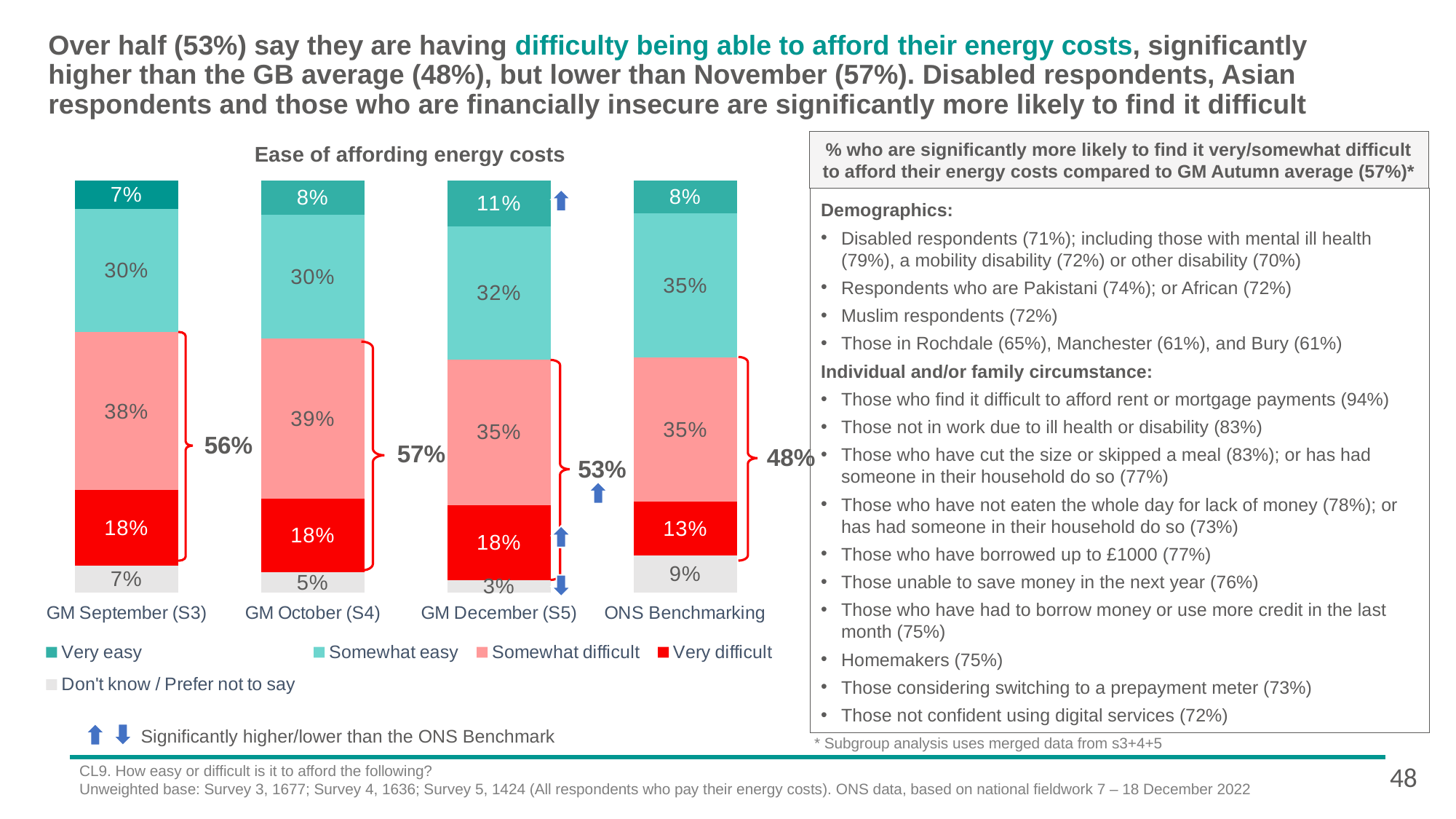
Which category has the highest 'Very easy' value? GM December (S5) How many series does the legend of the 'Ease of affording energy costs' chart list? 5 What is the 'Somewhat easy' value for GM December (S5)? 32% What is the 'Very difficult' value for ONS Benchmarking? 13% Which is larger: the 'Very difficult' value for GM September (S3) or for ONS Benchmarking? GM September (S3) Which category has the lowest 'Don't know / Prefer not to say' value? GM December (S5) What is the 'Don't know / Prefer not to say' value for GM October (S4)? 5% What type of chart is 'Ease of affording energy costs'? Stacked bar chart What is the difference between the 'Somewhat difficult' values for GM October (S4) and GM December (S5)? 4% Which colour represents 'Very difficult' in the chart? Red How many categories are shown on the x axis of the 'Ease of affording energy costs' chart? 4 What is the combined 'Somewhat difficult' and 'Very difficult' total shown for GM October (S4)? 57%